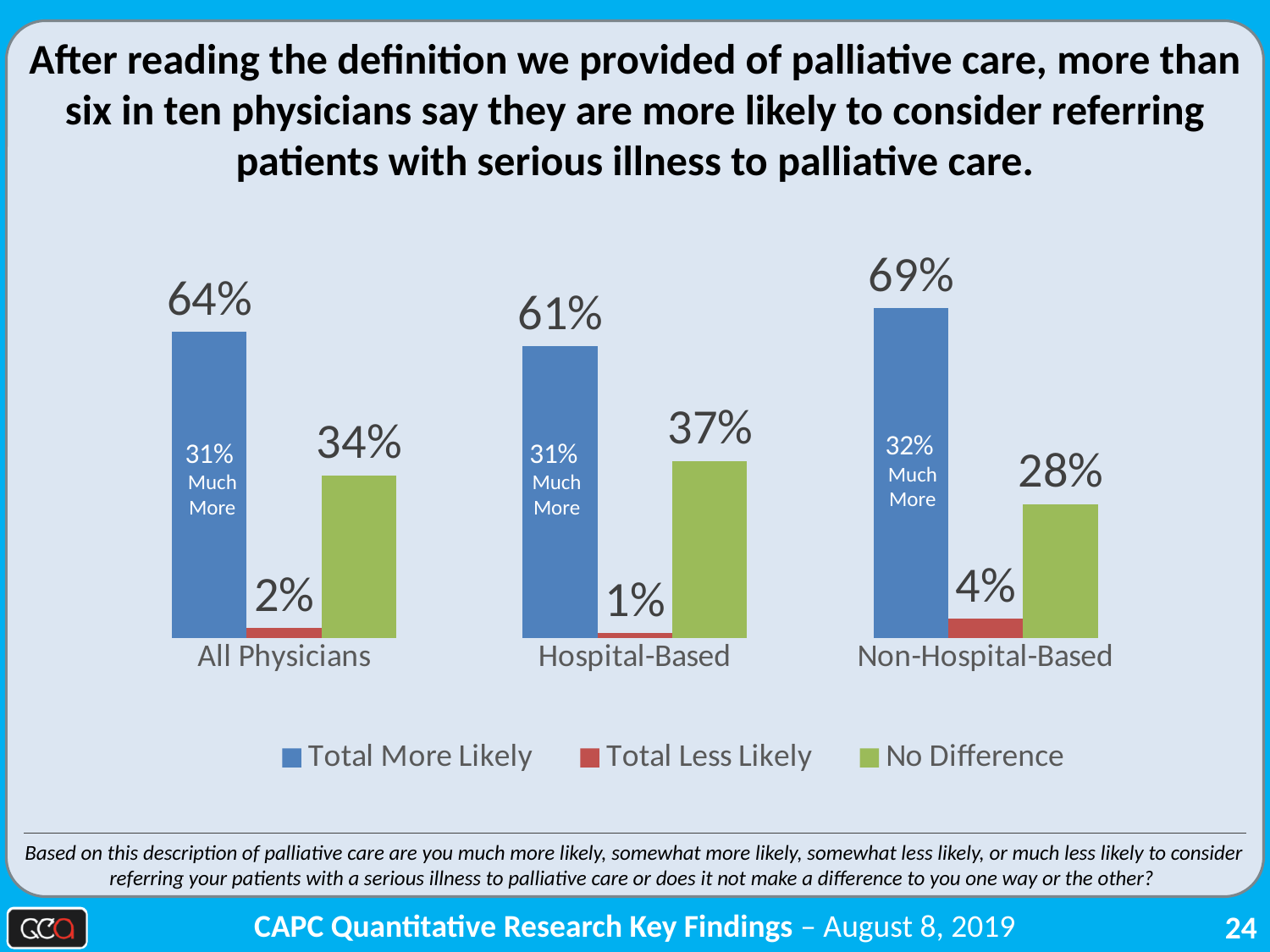
What is the No Difference value for Hospital-Based physicians? 37% Which category has the lowest Total Less Likely value? Hospital-Based What is the Total Less Likely value for Non-Hospital-Based physicians? 4% Which colour represents the No Difference series? Green What is the Total More Likely value for All Physicians? 64% What percentage of Non-Hospital-Based physicians say they are Much More likely? 32% What is the difference between the Total More Likely values for Non-Hospital-Based and Hospital-Based physicians? 8% What kind of chart is shown on the slide? Bar chart Which category has the highest Total More Likely value? Non-Hospital-Based How many categories are shown on the x axis? 3 Which is larger: the No Difference value for All Physicians or for Non-Hospital-Based physicians? All Physicians How many series does the legend list? 3